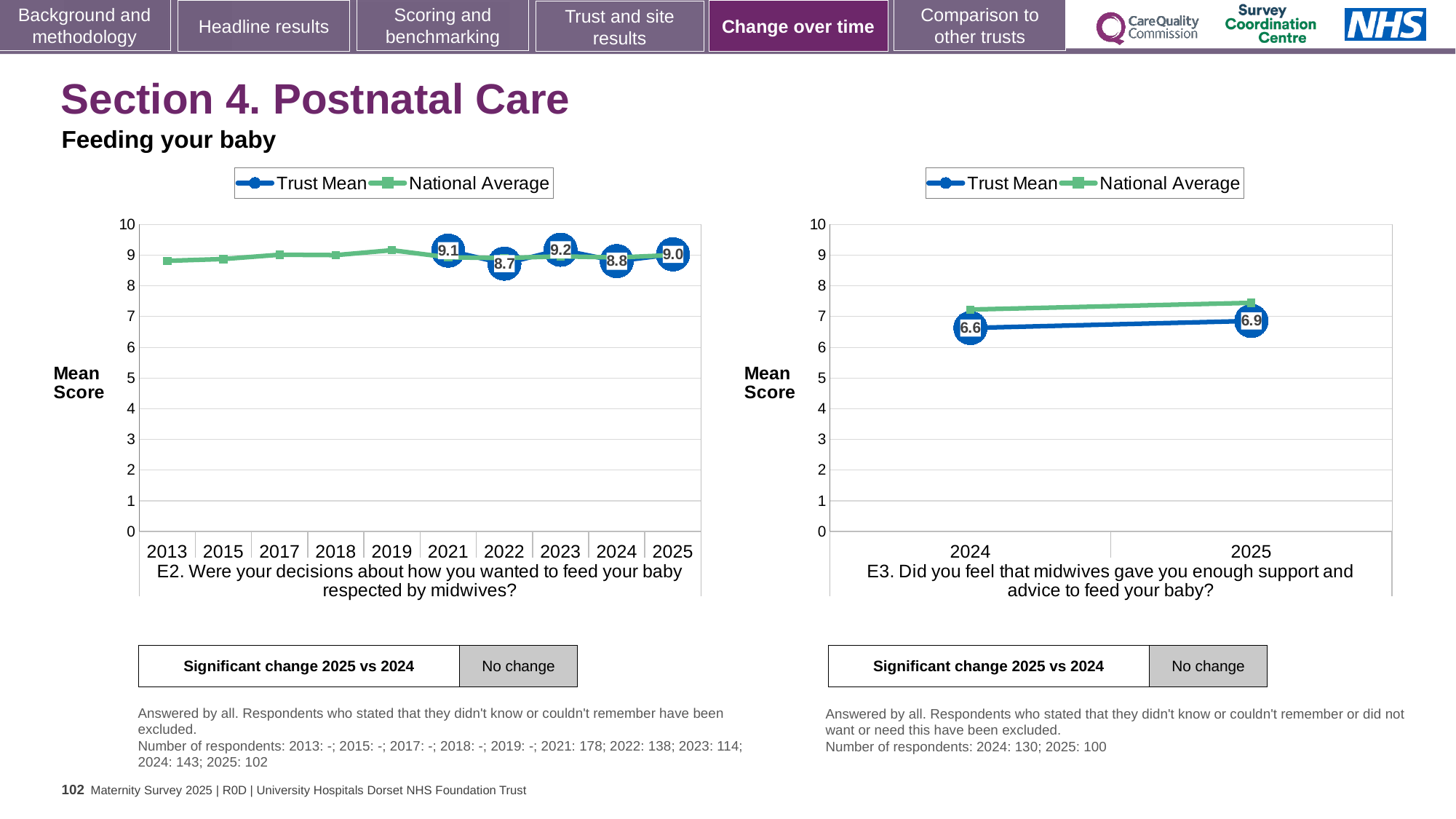
On the E2 chart (left), how many years are shown on the x axis? 10 On the E3 chart (right), what is the Trust Mean for 2024? 6.6 On the E2 chart (left), what is the Trust Mean for 2023? 9.2 On the E3 chart (right), does the Trust Mean rise or fall from 2024 to 2025? rise On the E2 chart (left), which year has the highest labelled Trust Mean? 2023 How many series does the legend of the E3 chart (right) list? 2 On the E2 chart (left), what is the Trust Mean for 2025? 9.0 On the E2 chart (left), which year has the lowest labelled Trust Mean? 2022 On the E2 chart (left), what is the Trust Mean for 2022? 8.7 On the E2 chart (left), what is the difference between the Trust Mean for 2023 and 2022? 0.5 On the E3 chart (right), is the National Average for 2025 greater or less than 7? greater On the E3 chart (right), what is the Trust Mean for 2025? 6.9